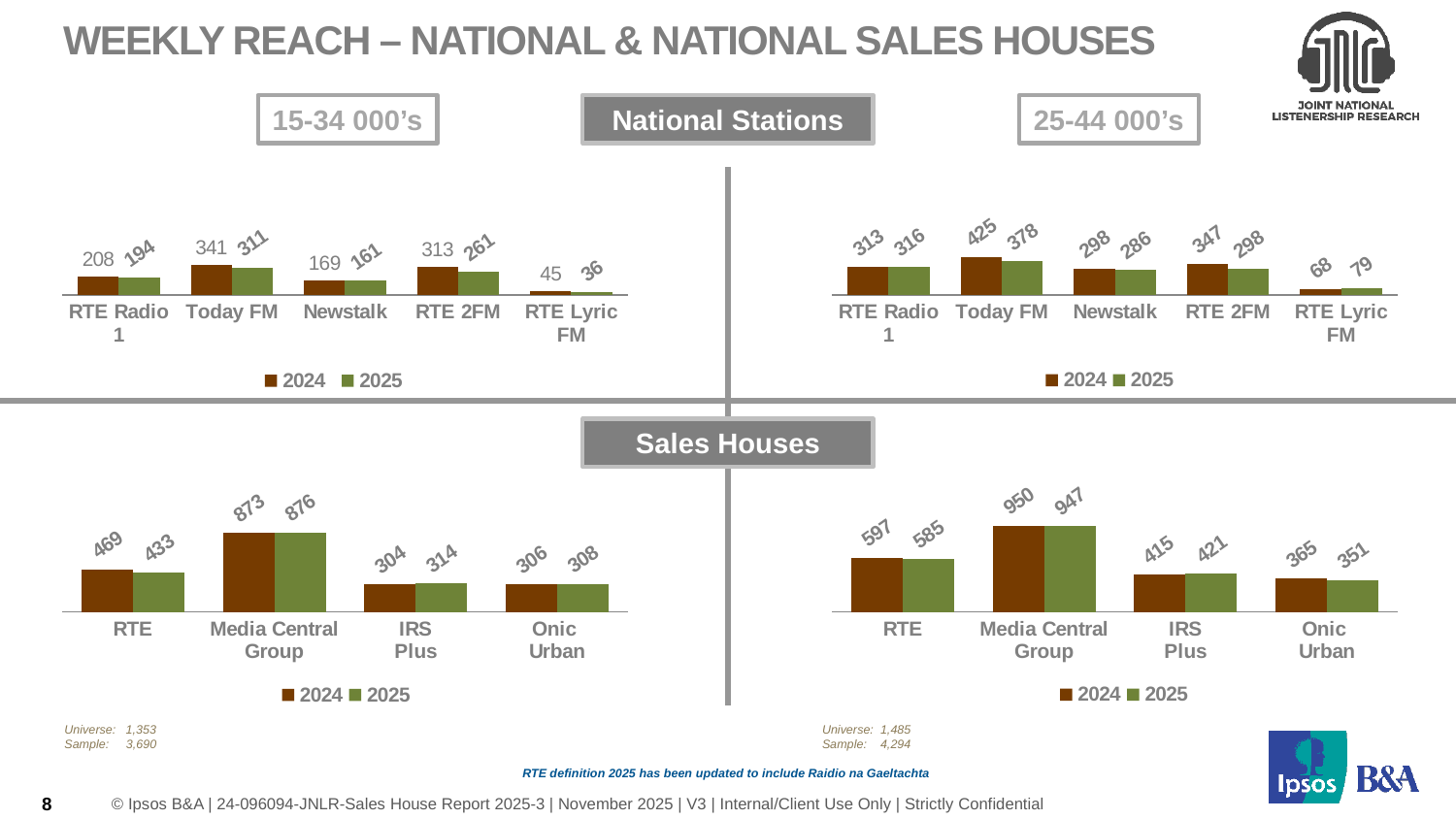
In the top-left National Stations 15-34 000's chart, which station has the lowest 2024 value? RTE Lyric FM In the bottom-left Sales Houses 15-34 000's chart, what is the 2025 value for Media Central Group? 876 In the bottom-left Sales Houses 15-34 000's chart, what is the difference between the 2024 and 2025 values for RTE? 36 In the bottom-right Sales Houses 25-44 000's chart, how many series does the legend list? 2 In the top-left National Stations 15-34 000's chart, what is the difference between the 2024 and 2025 values for RTE 2FM? 52 In the top-right National Stations 25-44 000's chart, how many stations are shown on the x axis? 5 In the top-left National Stations 15-34 000's chart, what is the 2025 value for Today FM? 311 In the top-right National Stations 25-44 000's chart, which is larger for RTE Lyric FM, the 2024 value or the 2025 value? 2025 In the bottom-left Sales Houses 15-34 000's chart, which sales house has the highest 2024 value? Media Central Group In the top-right National Stations 25-44 000's chart, what is the 2024 value for Today FM? 425 What type of chart is the bottom-right Sales Houses 25-44 000's chart? Bar chart In the bottom-right Sales Houses 25-44 000's chart, what is the 2025 value for Onic Urban? 351